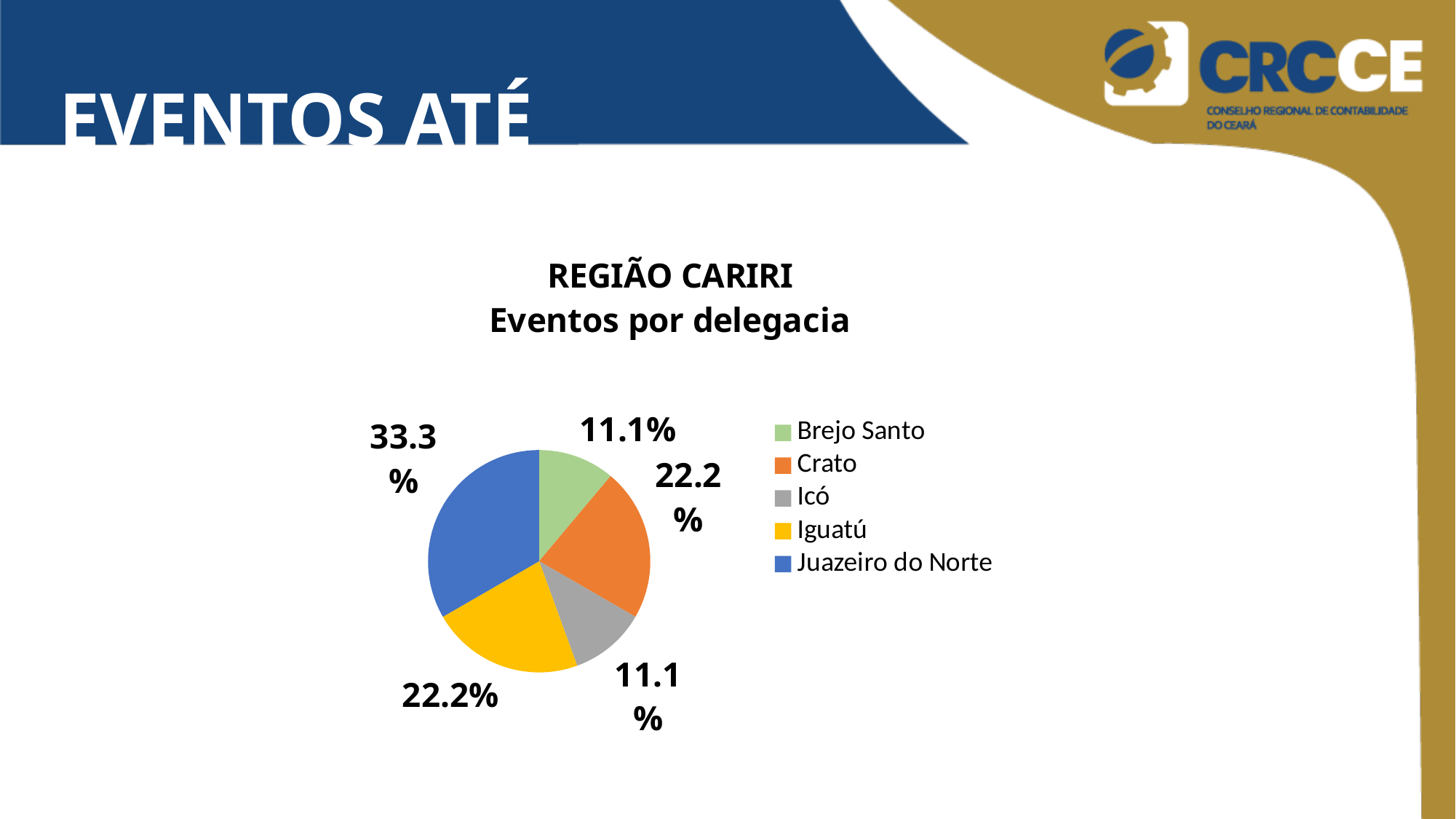
What share of events does Brejo Santo account for? 11.1% What kind of chart is shown on the slide? pie chart What is the difference in share between Juazeiro do Norte and Iguatú? 11.1% What share of events does Iguatú account for? 22.2% Which has a larger share of events, Juazeiro do Norte or Crato? Juazeiro do Norte What share of events does Juazeiro do Norte account for? 33.3% What share of events does Icó account for? 11.1% What share of events does Crato account for? 22.2% Which delegacia has the largest share of events? Juazeiro do Norte What is the title of the chart? REGIÃO CARIRI Eventos por delegacia How many delegacias (slices) does the pie chart show? 5 Which colour represents Juazeiro do Norte in the pie chart? blue